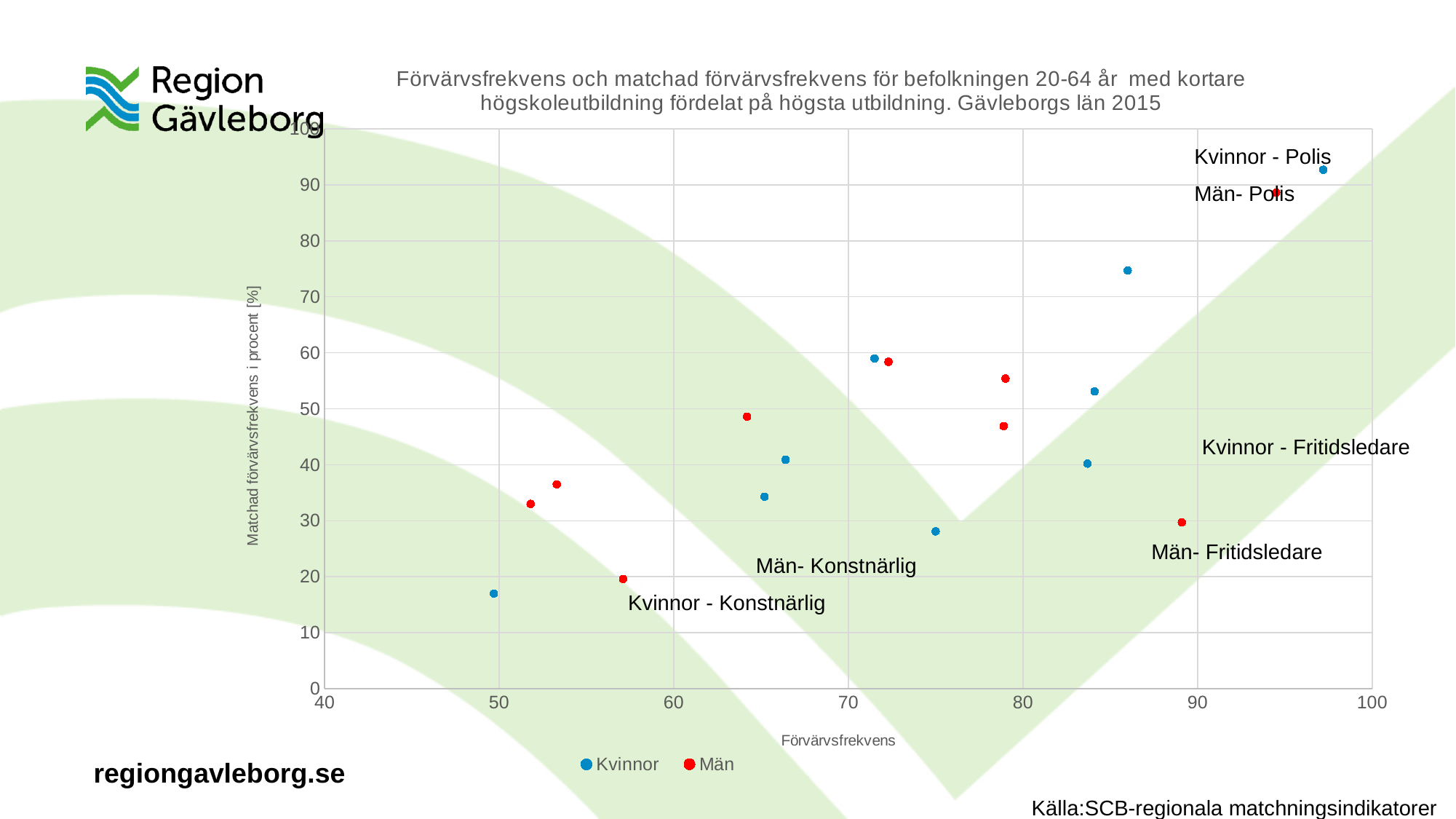
Which labeled point has the highest matched employment rate (y value)? Kvinnor - Polis Which has the higher matched employment rate (y value): Kvinnor - Fritidsledare or Män- Fritidsledare? Kvinnor - Fritidsledare Is the Förvärvsfrekvens (x value) for Kvinnor - Fritidsledare greater or less than 90? less Is the matched employment rate (y value) for Män- Fritidsledare greater or less than 40? less What are the two series named in the legend? Kvinnor and Män What is the label of the horizontal axis? Förvärvsfrekvens How many series does the legend list? 2 Is the Förvärvsfrekvens (x value) for Män- Fritidsledare greater or less than 80? greater What kind of chart is shown on the slide? scatter chart Which has the higher matched employment rate (y value): Kvinnor - Polis or Män- Polis? Kvinnor - Polis